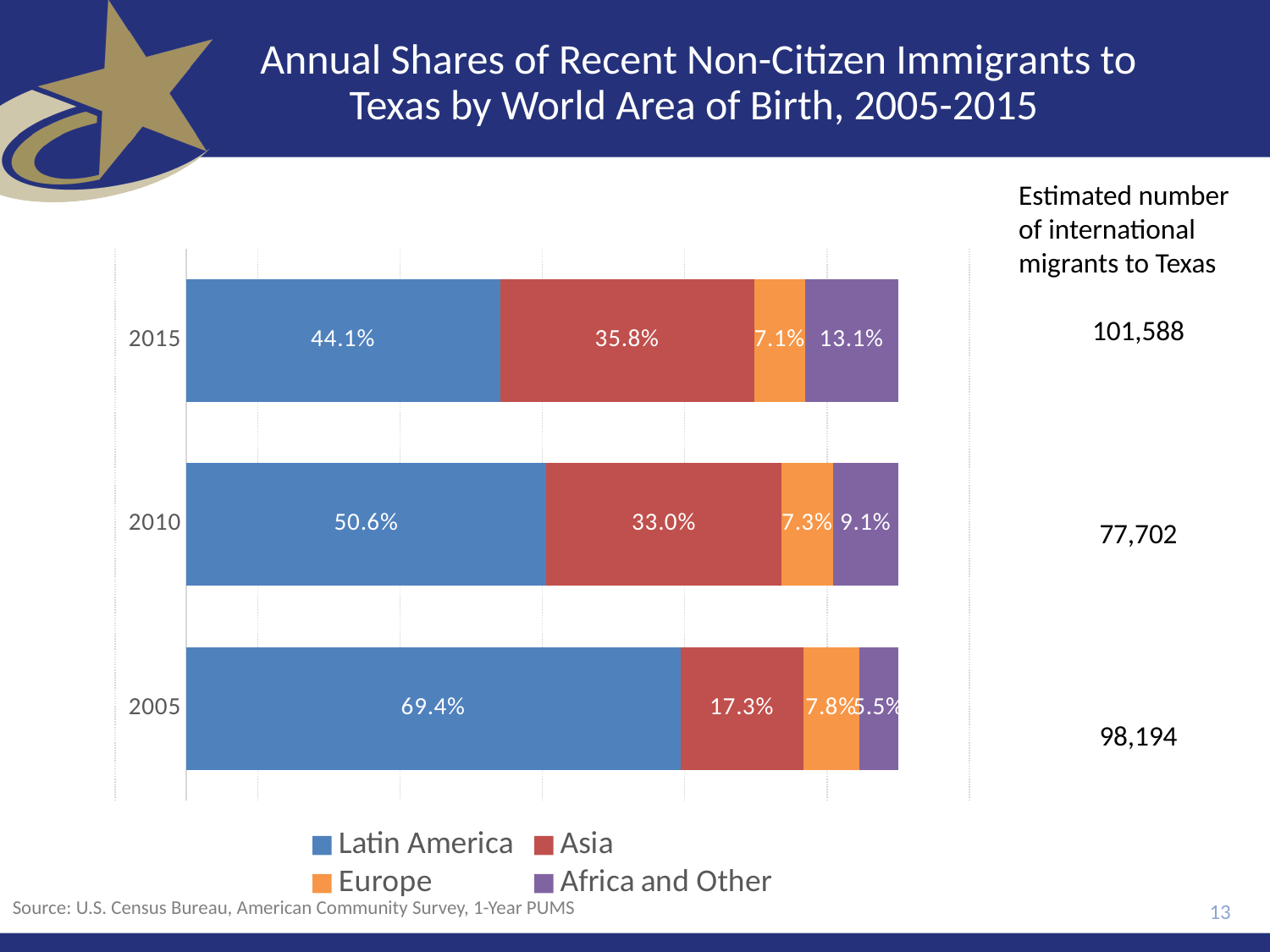
What is the Asia share for 2005? 17.3% In which year is the Latin America share the highest? 2005 By how many percentage points did the Latin America share fall from 2005 to 2015? 25.3 percentage points In which year is the Africa and Other share the lowest? 2005 How many series does the legend list? 4 Which year has the larger Asia share, 2010 or 2015? 2015 What is the Europe share for 2010? 7.3% How many years are shown in the chart? 3 Does the Latin America share rise or fall from 2005 to 2015? Fall What kind of chart is shown on the slide? Stacked bar chart What is the Africa and Other share for 2015? 13.1% What share of recent non-citizen immigrants to Texas in 2015 were born in Latin America? 44.1%